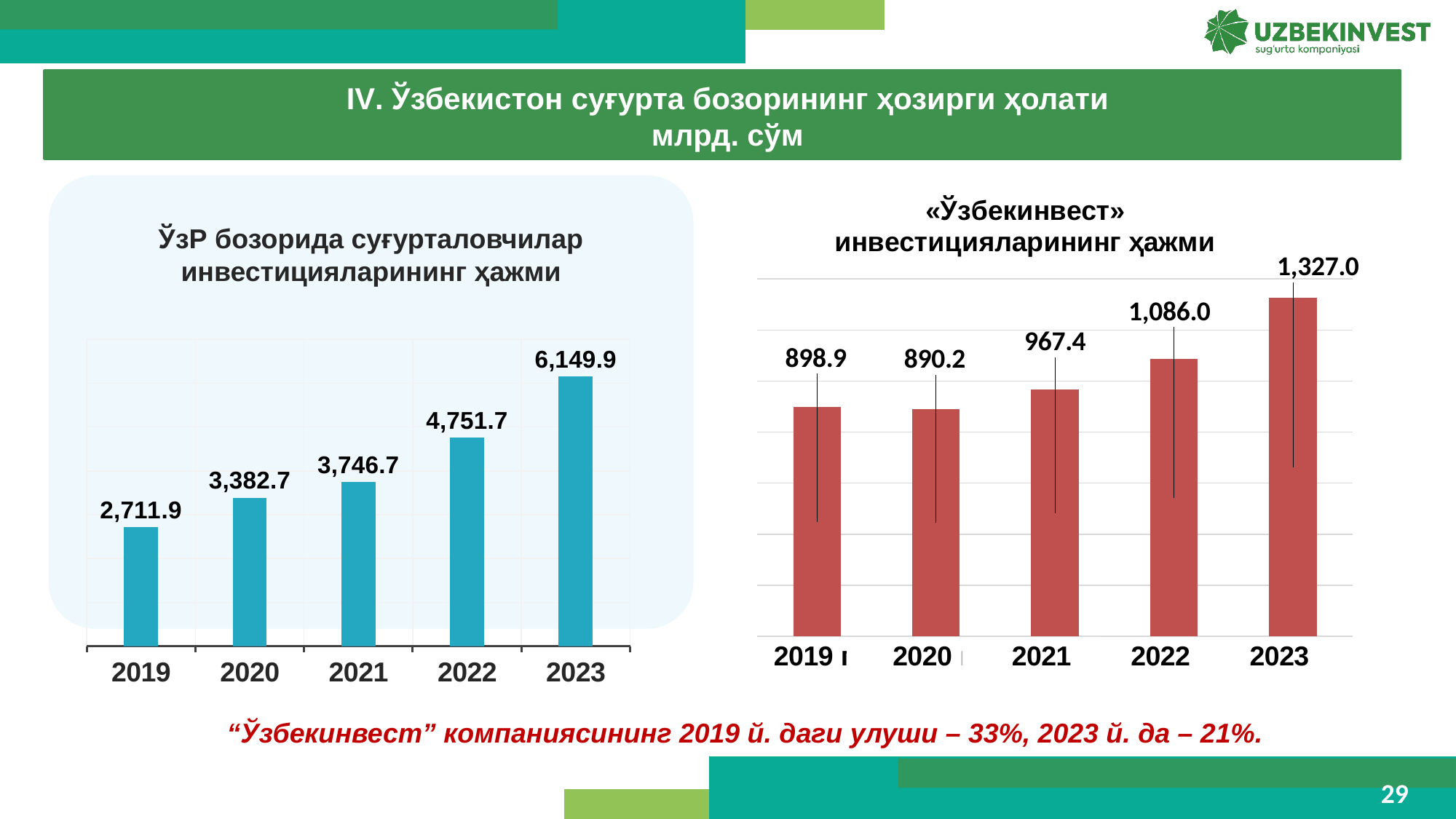
In the left chart (ЎзР бозорида суғурталовчилар инвестицияларининг ҳажми), what is the difference between the 2023 and 2022 values? 1,398.2 In the right chart («Ўзбекинвест» инвестицияларининг ҳажми), what is the value for 2022? 1,086.0 In the right chart («Ўзбекинвест» инвестицияларининг ҳажми), what is the value for 2021? 967.4 In the left chart (ЎзР бозорида суғурталовчилар инвестицияларининг ҳажми), which is larger, the value for 2021 or the value for 2022? 2022 In the left chart (ЎзР бозорида суғурталовчилар инвестицияларининг ҳажми), which year has the lowest value? 2019 In the right chart («Ўзбекинвест» инвестицияларининг ҳажми), what is the difference between the 2023 and 2019 values? 428.1 How many years are shown on the x axis of the right chart («Ўзбекинвест» инвестицияларининг ҳажми)? 5 In the left chart (ЎзР бозорида суғурталовчилар инвестицияларининг ҳажми), do the values rise or fall from 2019 to 2023? Rise In the left chart (ЎзР бозорида суғурталовчилар инвестицияларининг ҳажми), what is the value for 2023? 6,149.9 In the left chart (ЎзР бозорида суғурталовчилар инвестицияларининг ҳажми), what is the value for 2019? 2,711.9 In the right chart («Ўзбекинвест» инвестицияларининг ҳажми), which year has the highest value? 2023 What type of chart is the left chart (ЎзР бозорида суғурталовчилар инвестицияларининг ҳажми)? Bar chart